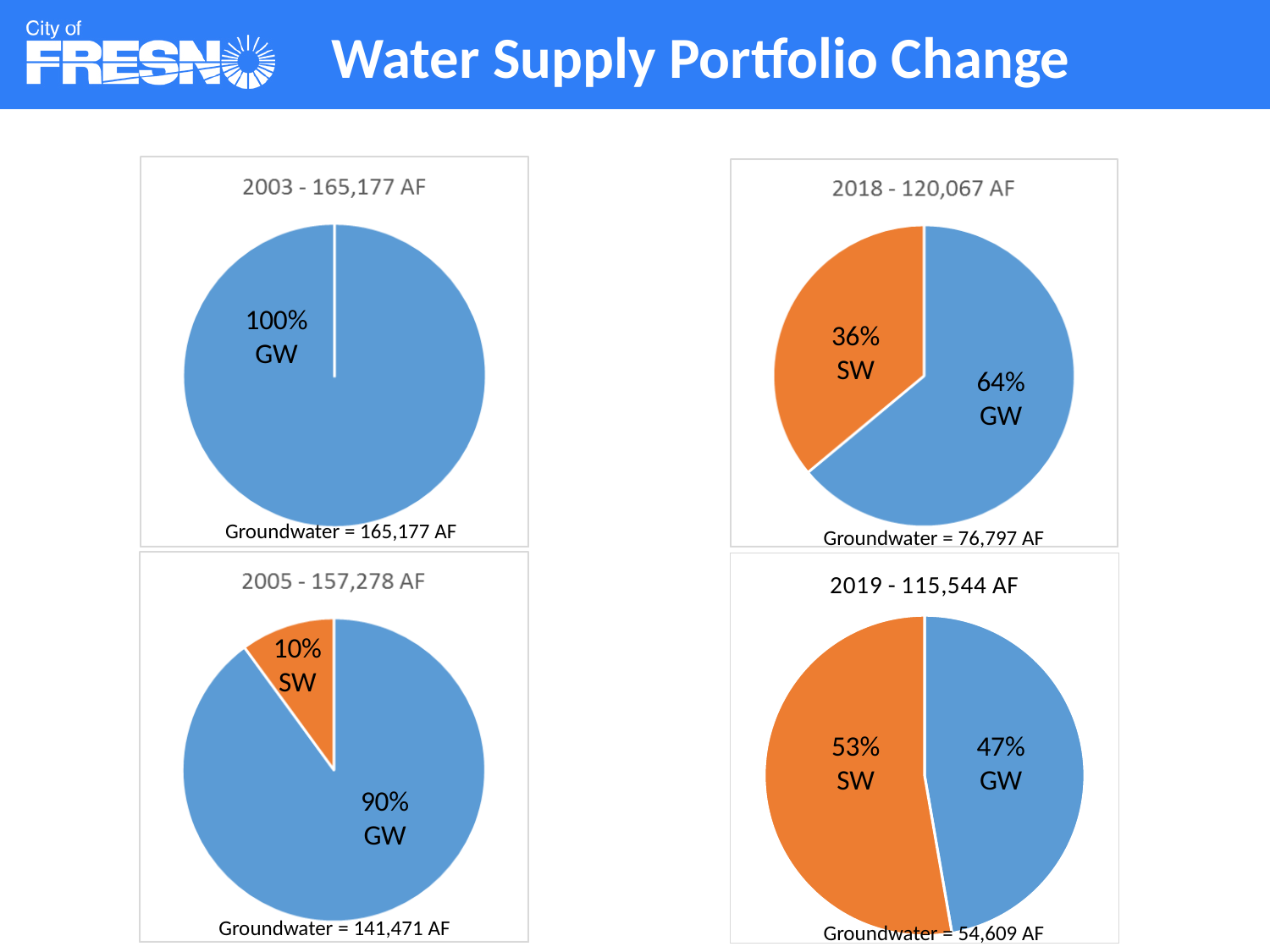
In the "2005 - 157,278 AF" chart, which slice is the smallest? SW In the "2018 - 120,067 AF" chart, what is the groundwater amount shown below the pie? 76,797 AF In the "2018 - 120,067 AF" chart, what share of the pie is SW? 36% What kind of chart is the "2018 - 120,067 AF" chart? pie chart In the "2005 - 157,278 AF" chart, what share of the pie is SW? 10% How many pie charts are shown on the slide? 4 In the "2018 - 120,067 AF" chart, what is the difference in percentage points between the GW and SW slices? 28 In the "2019 - 115,544 AF" chart, what is the groundwater amount shown below the pie? 54,609 AF In the "2019 - 115,544 AF" chart, which slice is larger, SW or GW? SW In the "2003 - 165,177 AF" chart, what share of the pie is GW? 100% In the "2018 - 120,067 AF" chart, which slice is the largest? GW